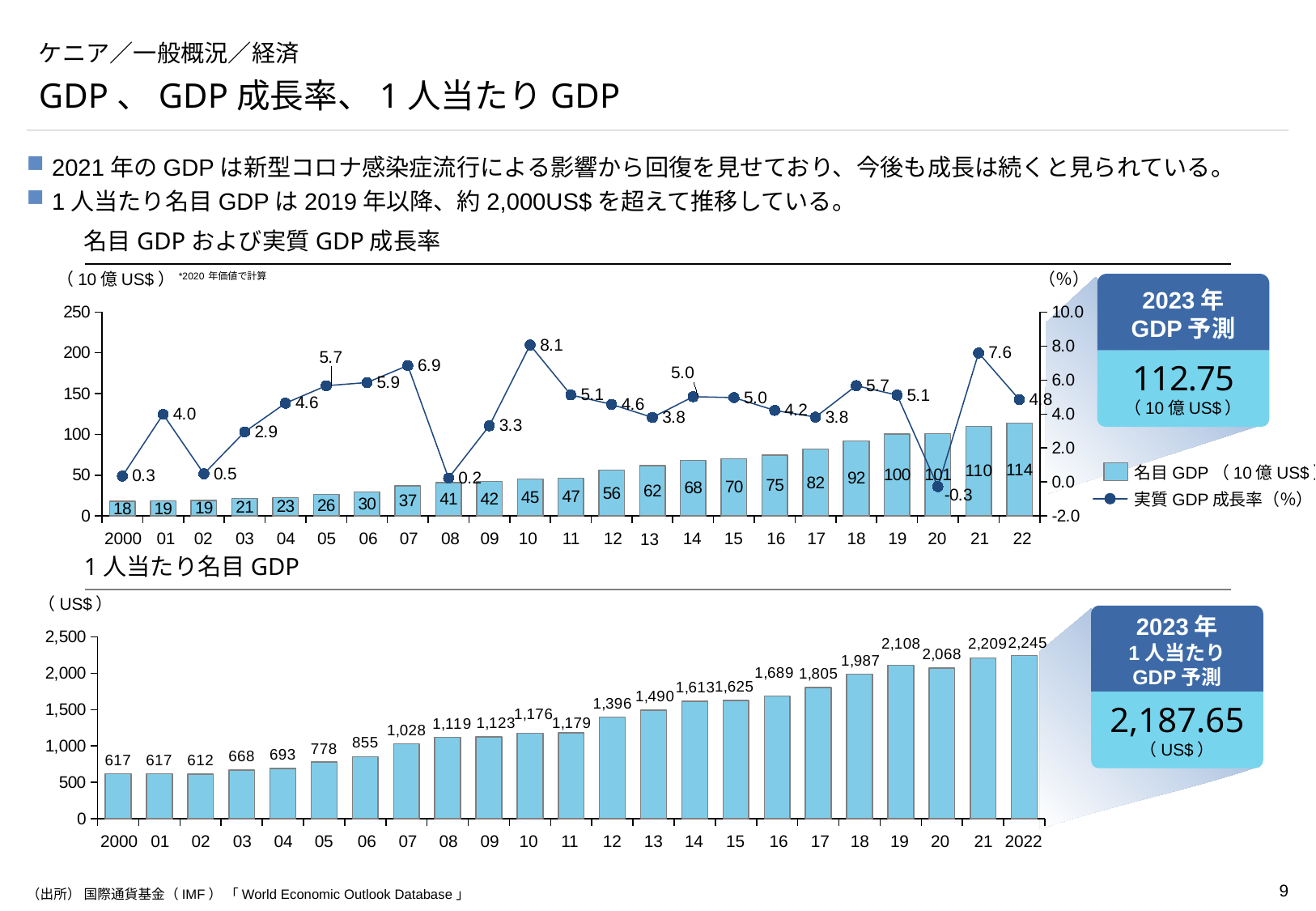
In the top chart (名目 GDP および実質 GDP 成長率), which year has the highest real GDP growth rate? 2010 What kind of chart is the bottom chart (1 人当たり名目 GDP)? Bar chart How many series does the legend of the top chart (名目 GDP および実質 GDP 成長率) list? 2 In the top chart (名目 GDP および実質 GDP 成長率), which year has the lowest real GDP growth rate? 2020 In the top chart (名目 GDP および実質 GDP 成長率), what is the nominal GDP value for 2015? 70 In the bottom chart (1 人当たり名目 GDP), what is the value for 2018? 1,987 In the bottom chart (1 人当たり名目 GDP), which year has the highest value? 2022 In the top chart (名目 GDP および実質 GDP 成長率), what is the real GDP growth rate for 2010? 8.1 In the top chart (名目 GDP および実質 GDP 成長率), which year has the higher real GDP growth rate, 2007 or 2021? 2021 In the top chart (名目 GDP および実質 GDP 成長率), how much larger is nominal GDP in 2022 than in 2000? 96 In the bottom chart (1 人当たり名目 GDP), what is the difference between the 2019 and 2020 values? 40 How many years (bars) are shown in the bottom chart (1 人当たり名目 GDP)? 23